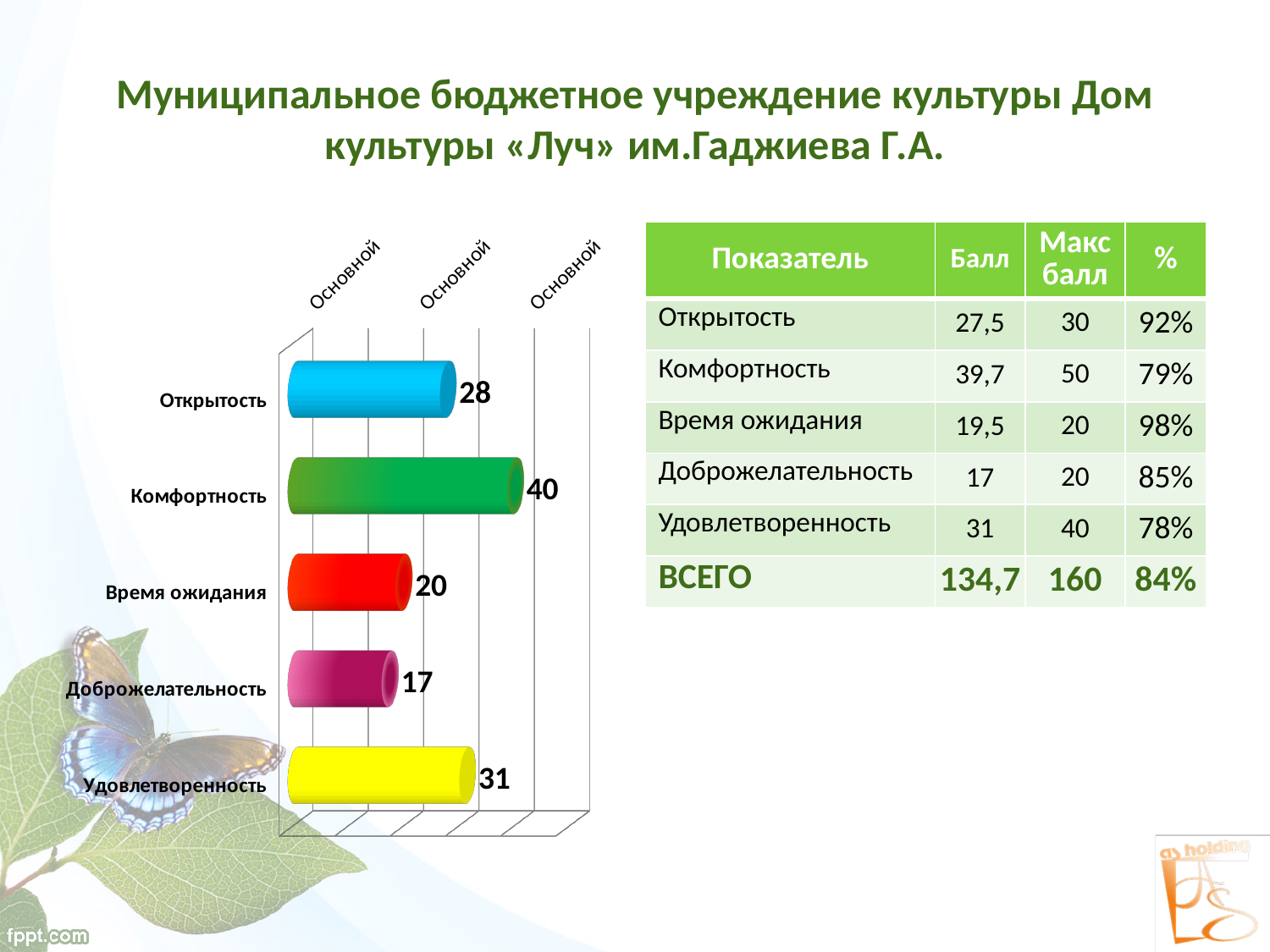
Which has a larger value in the chart, Открытость or Удовлетворенность? Удовлетворенность What value does the chart show for Время ожидания? 20 What colour is the bar for Время ожидания? Red What value does the chart show for Комфортность? 40 What is the difference between the chart values for Удовлетворенность and Доброжелательность? 14 Which category has the highest value in the chart? Комфортность What value does the chart show for Доброжелательность? 17 What is the difference between the chart values for Комфортность and Открытость? 12 What value does the chart show for Удовлетворенность? 31 How many categories are shown in the chart? 5 What type of chart is shown on the slide? Bar chart Which category has the lowest value in the chart? Доброжелательность